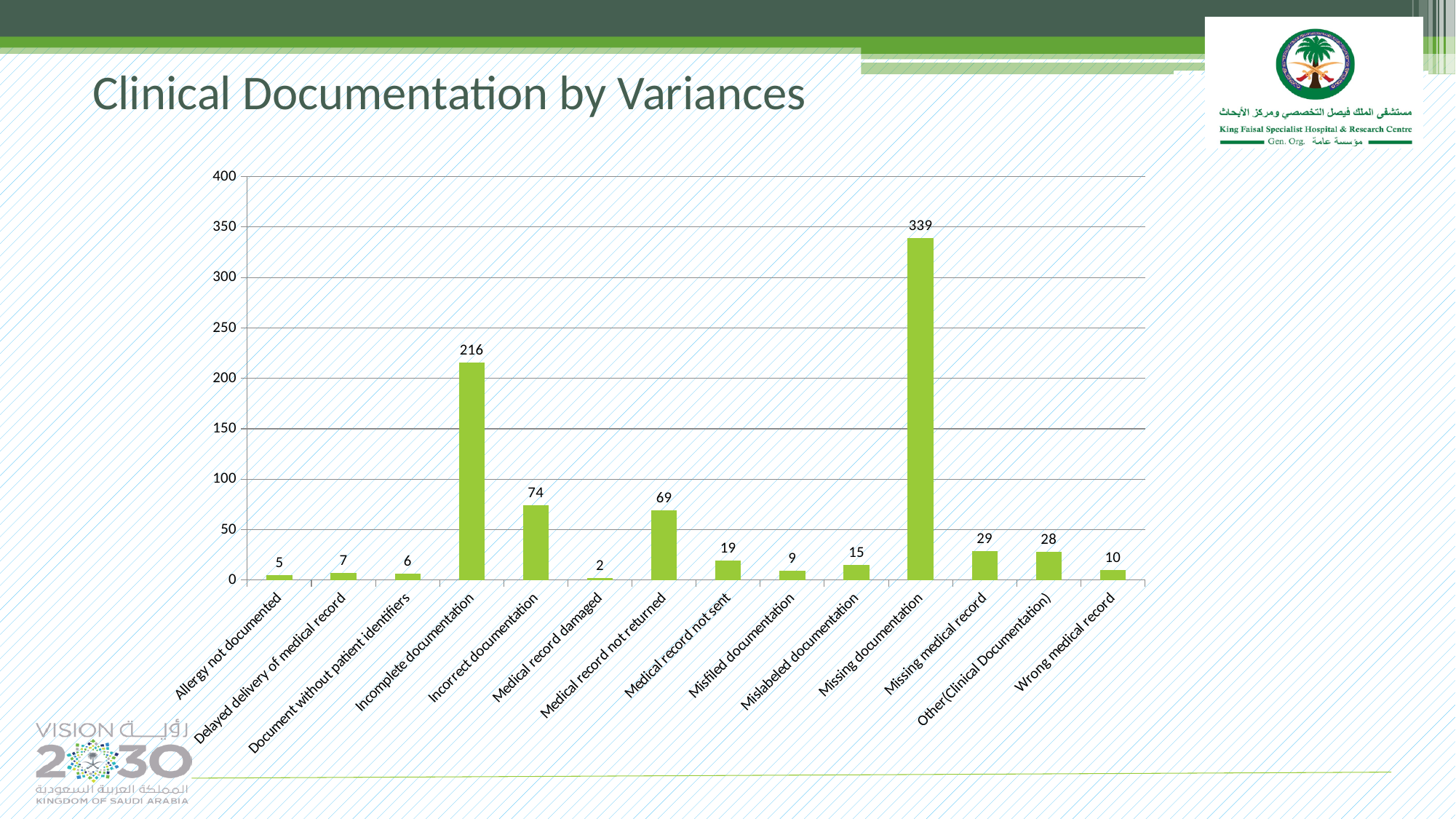
What kind of chart is shown on the slide? bar chart What is the difference between Missing documentation and Incomplete documentation? 123 What is the value for Medical record damaged? 2 Is the value for Missing documentation greater or less than 300? greater What is the value for Medical record not returned? 69 Which category has the lowest value? Medical record damaged How many categories are shown on the x axis? 14 Which is larger, Incorrect documentation or Medical record not returned? Incorrect documentation What is the value for Missing documentation? 339 What is the value for Incomplete documentation? 216 Which category has the highest value? Missing documentation What is the title of the slide? Clinical Documentation by Variances